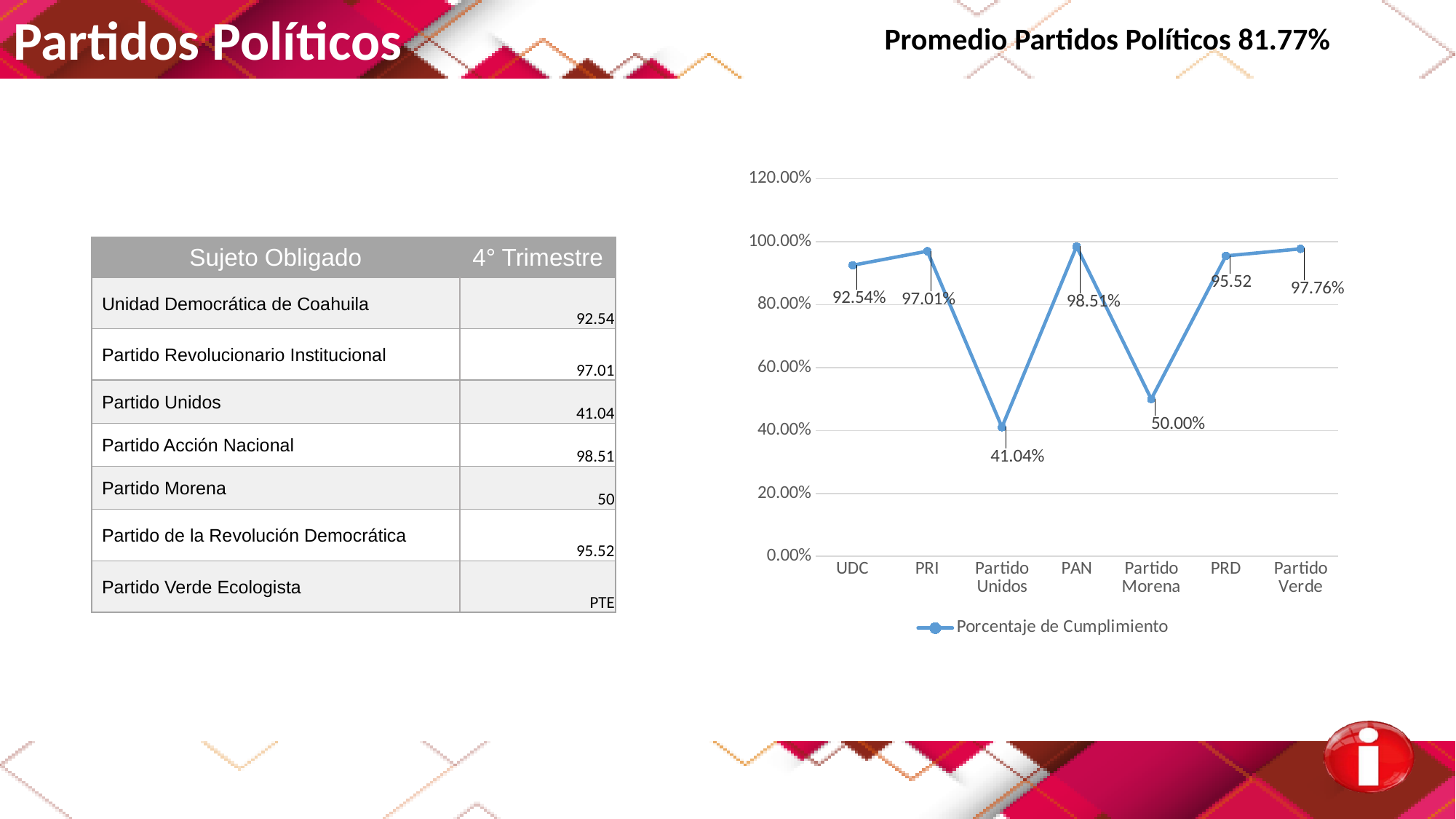
What type of chart is shown on the slide? Line chart What is the value for Partido Morena in the line chart? 50.00% What is the value for PAN in the line chart? 98.51% What is the value for Partido Verde in the line chart? 97.76% What is the value for Partido Unidos in the line chart? 41.04% What series name does the legend of the chart show? Porcentaje de Cumplimiento Which category has the lowest value in the line chart? Partido Unidos Which category has the highest value in the line chart? PAN What is the value for UDC in the line chart? 92.54% Which has a larger value in the line chart, PRI or UDC? PRI How many categories are plotted on the x axis of the line chart? 7 What is the difference between the values for PAN and Partido Unidos in the line chart? 57.47%